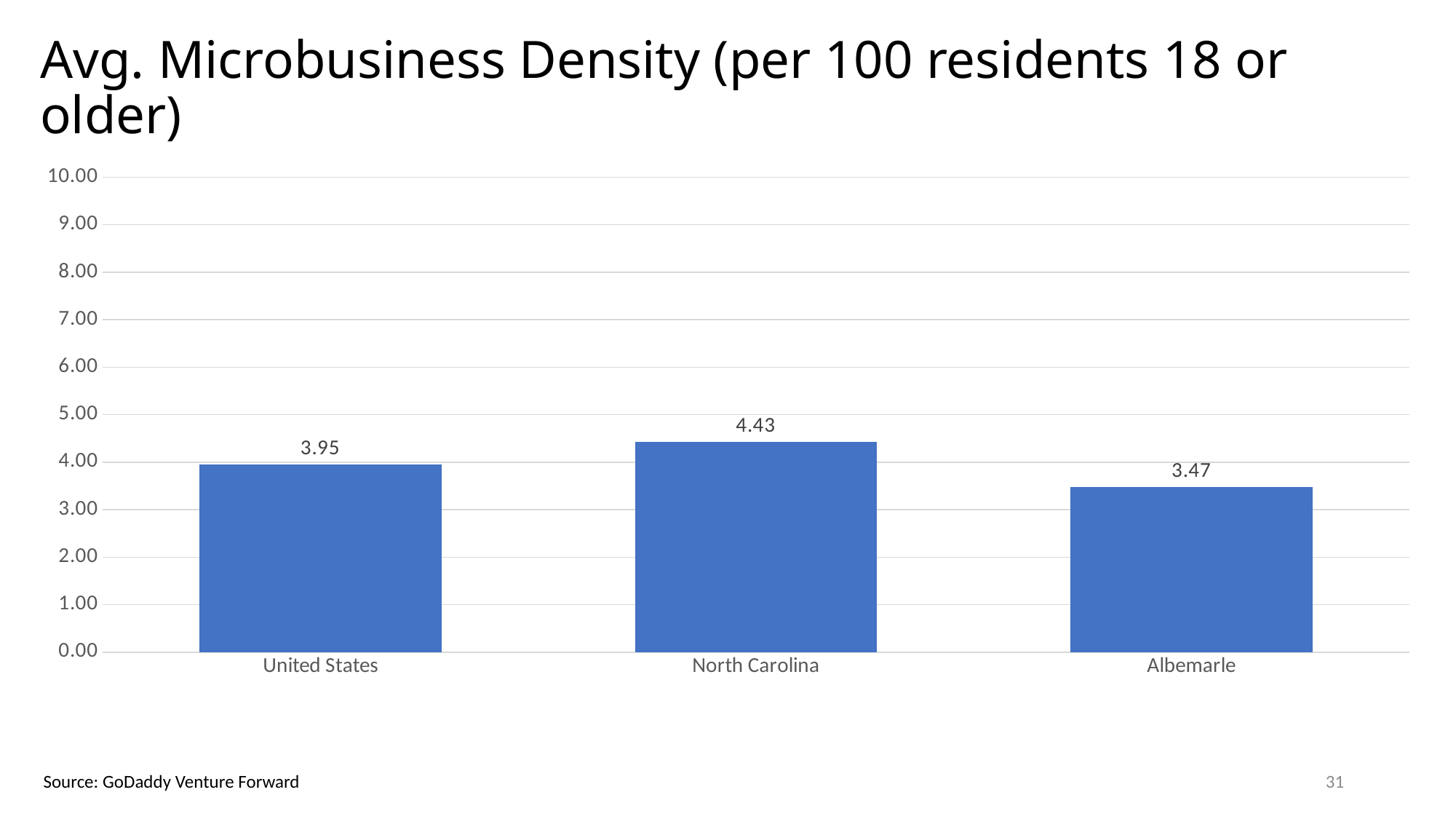
What source is cited for the chart data? GoDaddy Venture Forward What is the average microbusiness density for Albemarle? 3.47 What is the difference between the microbusiness density of North Carolina and the United States? 0.48 What is the average microbusiness density for the United States? 3.95 What is the difference between the microbusiness density of the United States and Albemarle? 0.48 Which category has the lowest average microbusiness density? Albemarle How many categories are shown on the chart? 3 What kind of chart is shown on the slide? Bar chart Is the value for North Carolina greater or less than 4.00? greater Which has a higher microbusiness density, the United States or Albemarle? United States What is the average microbusiness density for North Carolina? 4.43 Which category has the highest average microbusiness density? North Carolina